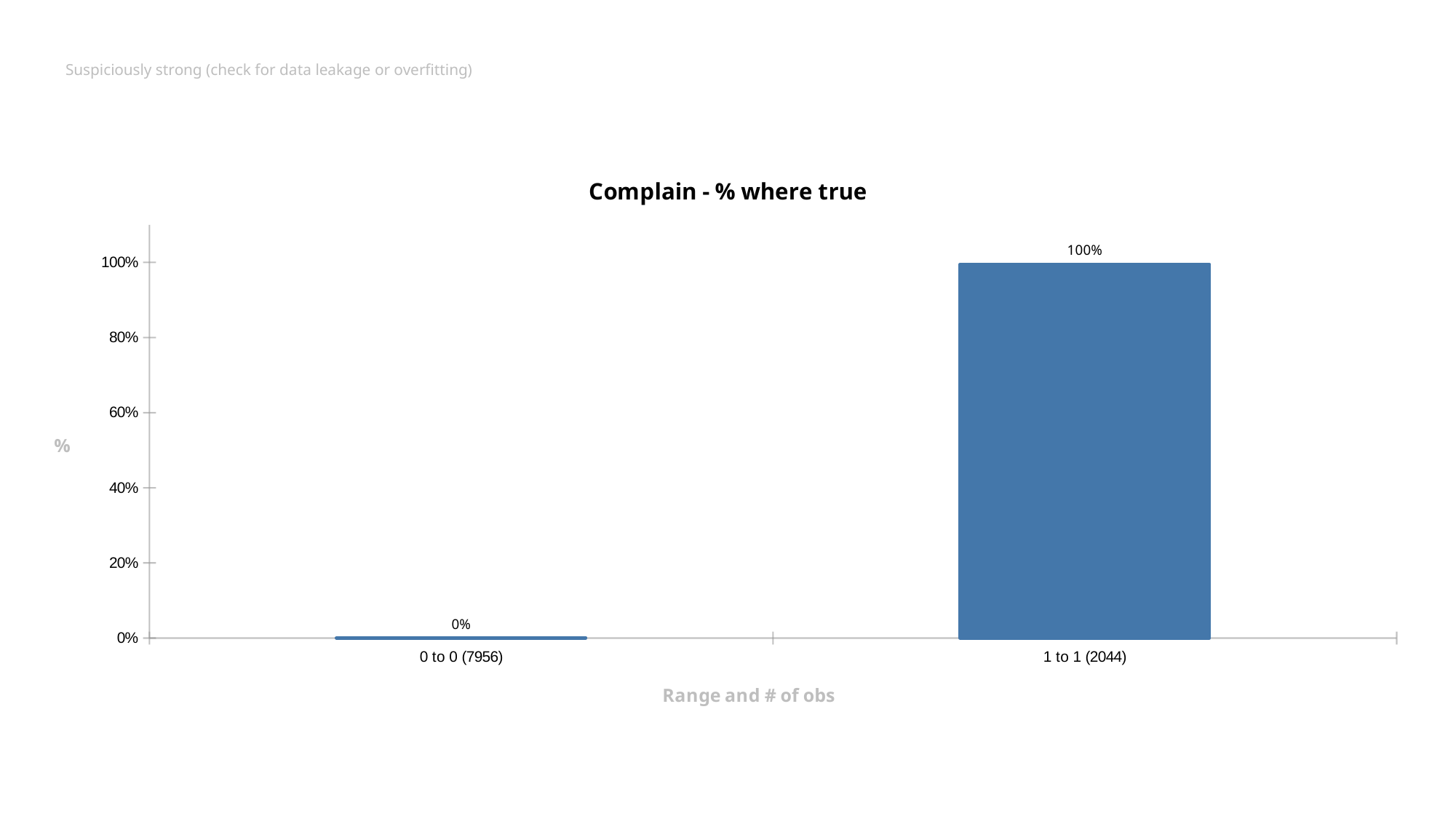
What kind of chart is shown on the slide? bar chart What is the difference between the values for "1 to 1 (2044)" and "0 to 0 (7956)"? 100% How many categories are shown on the x axis? 2 What is the value for the category "0 to 0 (7956)"? 0% Which is larger, the value for "0 to 0 (7956)" or the value for "1 to 1 (2044)"? 1 to 1 (2044) What is the label of the x axis? Range and # of obs Which category has the lowest value? 0 to 0 (7956) What is the value for the category "1 to 1 (2044)"? 100% Is the value for "1 to 1 (2044)" greater or less than 60%? greater What is the title of the chart? Complain - % where true Do the values rise or fall from left to right along the x axis? rise Which category has the highest value? 1 to 1 (2044)